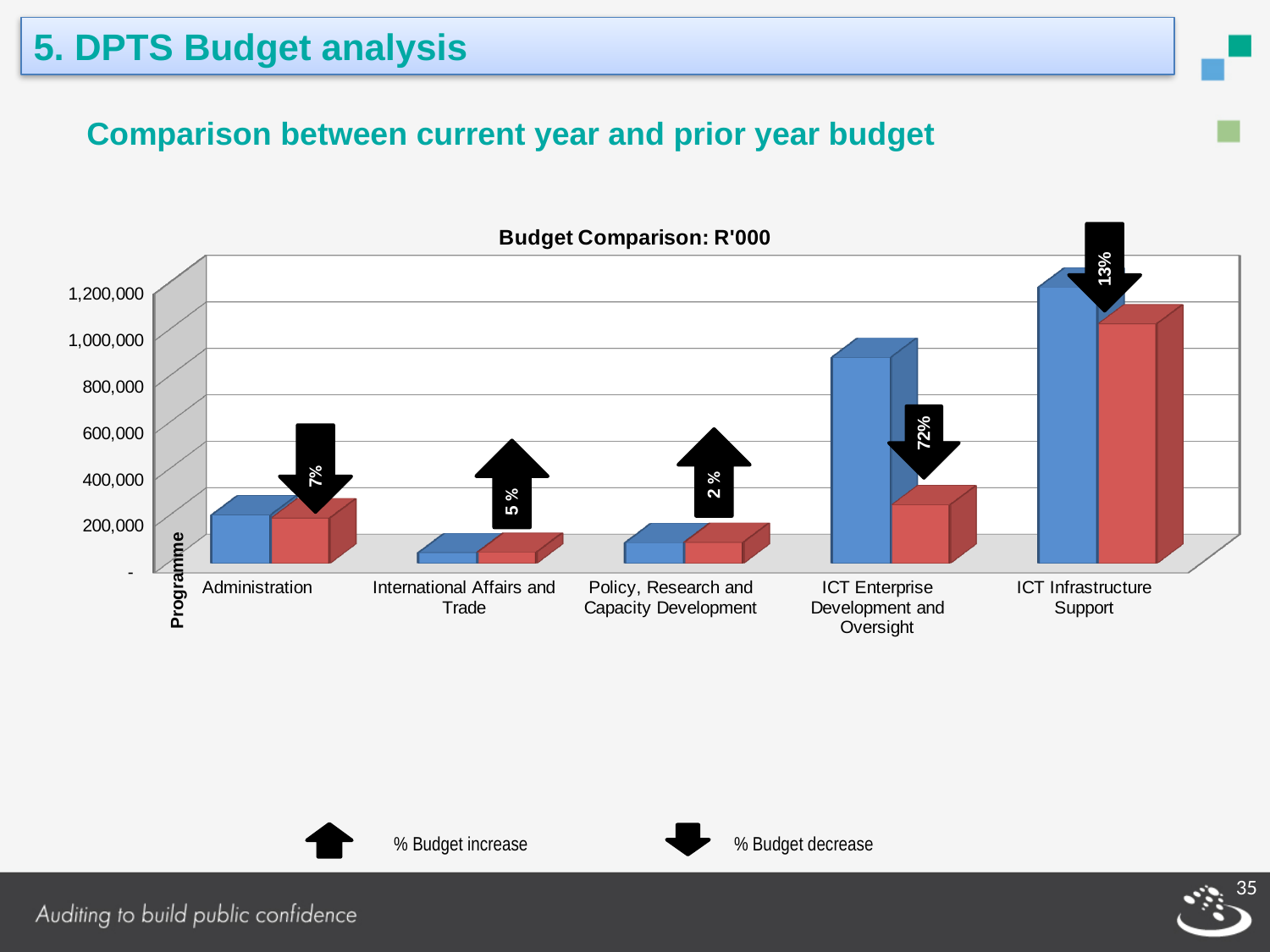
What percentage change is shown by the arrow above the Administration bars? 7% What percentage change is shown by the arrow above the ICT Infrastructure Support bars? 13% How many programmes are shown on the x axis of the chart? 5 Does the arrow for International Affairs and Trade indicate a budget increase or a budget decrease? Budget increase What is the title of the chart? Budget Comparison: R'000 Is the value of the blue bar for ICT Infrastructure Support greater or less than 1,000,000? greater Which programme has the highest budget bars in the chart? ICT Infrastructure Support Which programme has the lowest budget bars in the chart? International Affairs and Trade What percentage change is shown by the arrow above the ICT Enterprise Development and Oversight bars? 72% For ICT Enterprise Development and Oversight, which bar is larger, the blue bar or the red bar? The blue bar Is the value of the blue bar for Administration greater or less than 400,000? less What kind of chart is shown on the slide? Bar chart